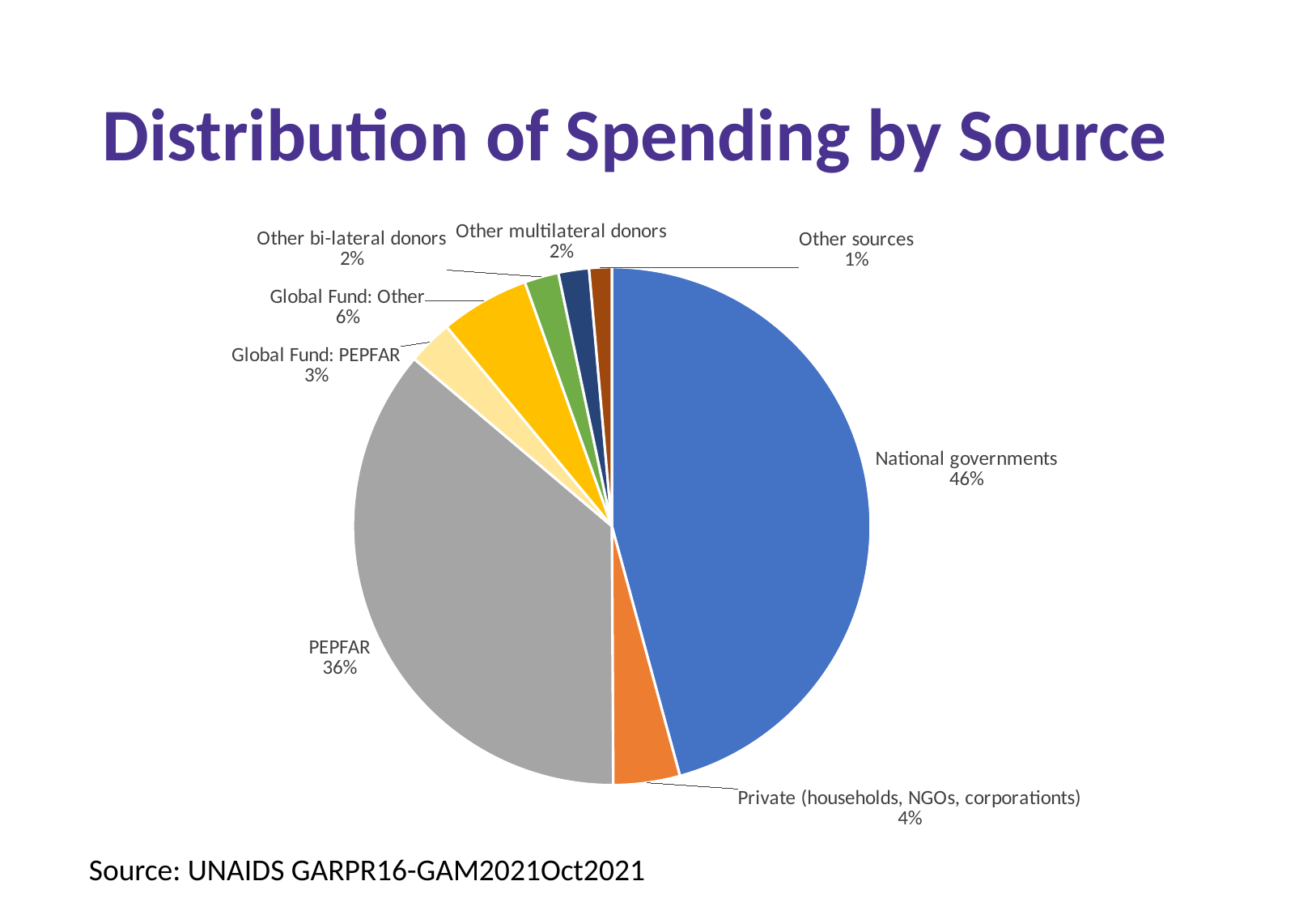
Which is larger: the share for Global Fund: Other or the share for Private (households, NGOs, corporations)? Global Fund: Other Which source accounts for the smallest share of spending? Other sources What share of spending comes from Global Fund: PEPFAR? 3% What percentage of spending is attributed to Global Fund: Other? 6% What type of chart is shown on the slide? Pie chart What share of spending comes from PEPFAR? 36% What percentage of spending comes from Private (households, NGOs, corporations)? 4% What is the title of the chart? Distribution of Spending by Source What share of spending comes from National governments? 46% What is the difference in percentage points between National governments and PEPFAR? 10 How many sources are shown in the pie chart? 8 Which source accounts for the largest share of spending? National governments